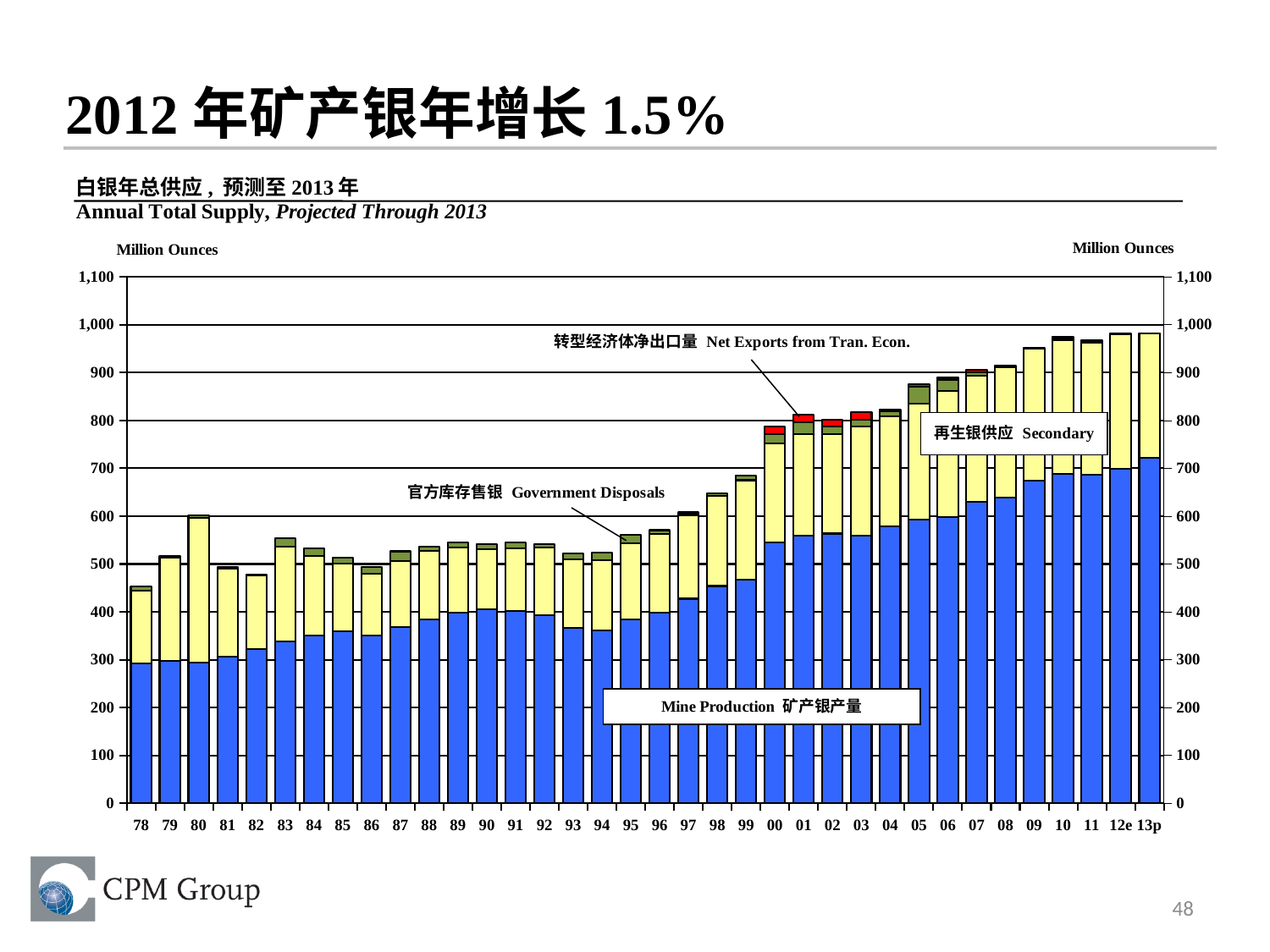
Which year has the lowest total supply bar? 78 What kind of chart is shown on the slide? Stacked bar chart Is the total supply bar for 78 greater or less than 500? less Which series forms the bottom (blue) segment of each stacked bar? Mine Production Which year has the highest Mine Production value? 13p How many years (bars) are plotted on the chart, from 78 through 13p? 36 Is the Mine Production value for 00 greater or less than 500? greater Is the total supply bar for 82 greater or less than 500? less What unit is shown on the vertical axis of the chart? Million Ounces Which year has the larger total supply bar, 80 or 81? 80